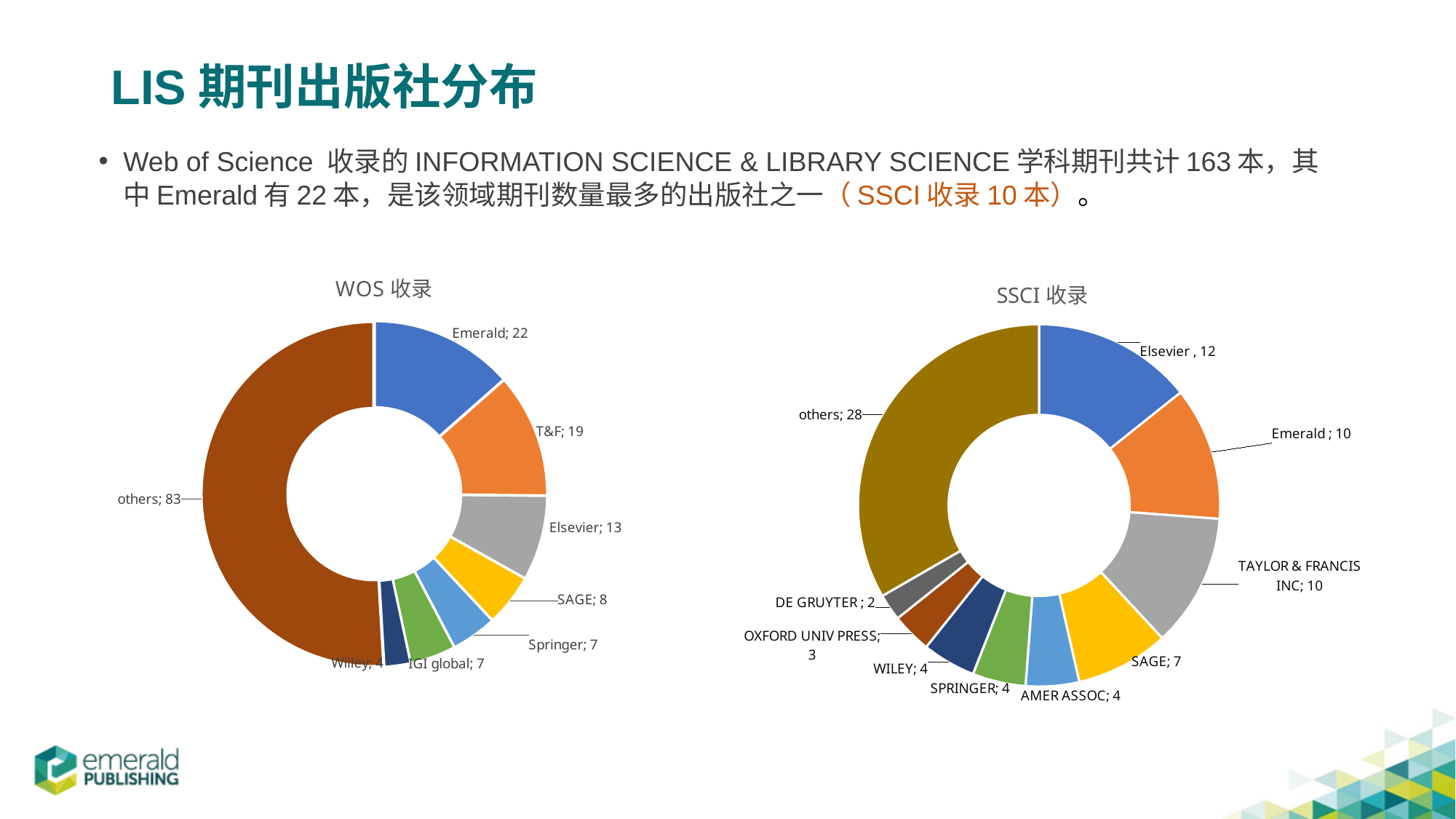
In the WOS 收录 chart, what is the value for T&F? 19 What kind of chart is the WOS 收录 chart? Doughnut chart In the SSCI 收录 chart, what is the difference between the values for others and Elsevier? 16 In the WOS 收录 chart, what is the difference between the values for Emerald and Elsevier? 9 In the WOS 收录 chart, how many journals does Emerald have? 22 How many categories are shown in the SSCI 收录 chart? 10 In the SSCI 收录 chart, what is the value for Elsevier? 12 In the WOS 收录 chart, which category has the largest slice? others In the WOS 收录 chart, which is larger, the value for SAGE or the value for Springer? SAGE What is the title of the chart on the right side of the slide? SSCI 收录 In the SSCI 收录 chart, what is the value for OXFORD UNIV PRESS? 3 In the SSCI 收录 chart, which named publisher (excluding others) has the smallest slice? DE GRUYTER